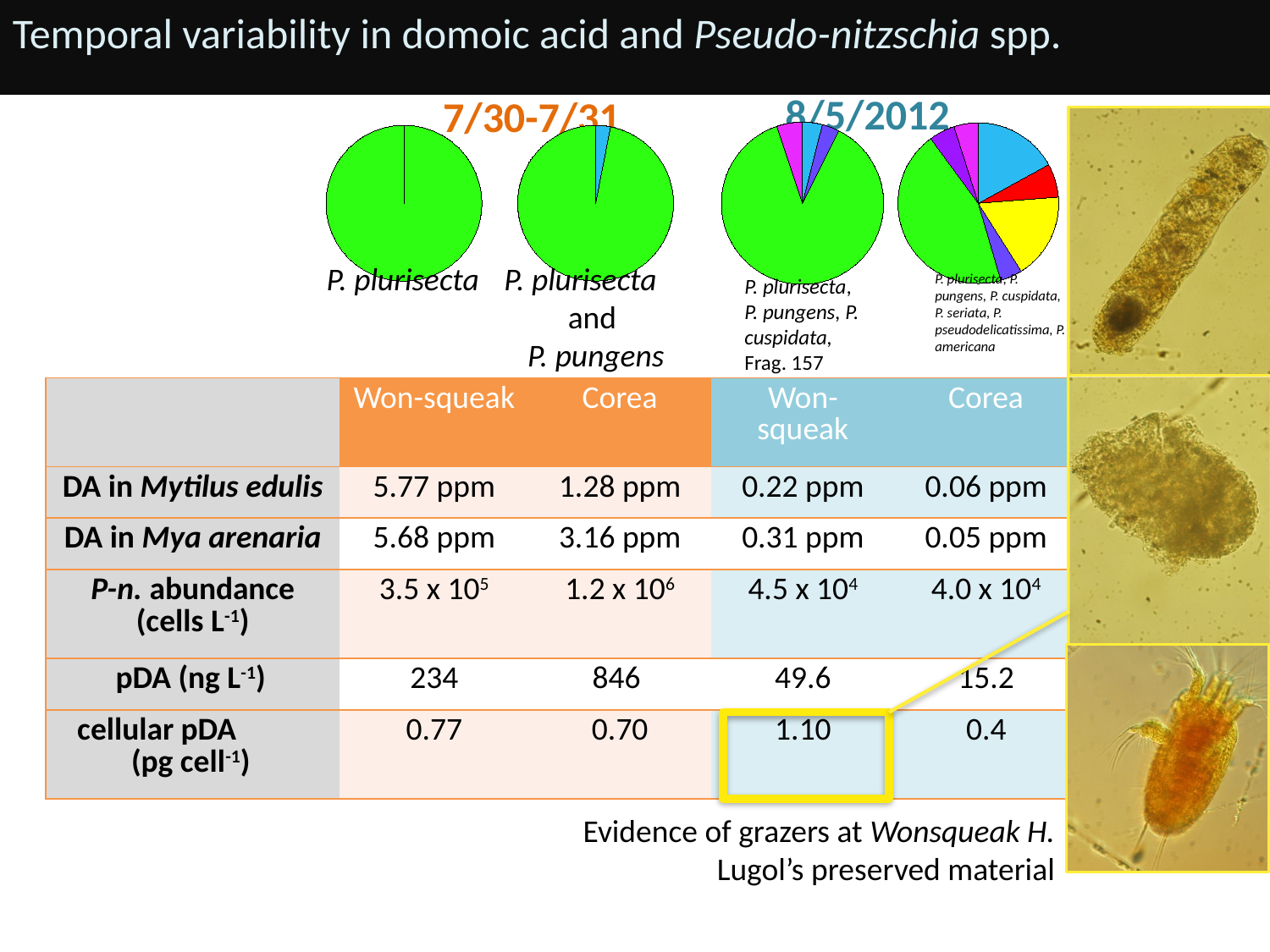
Which date label is shown above the two right-hand pie charts? 8/5/2012 In the third pie chart from the left (8/5/2012, Won-squeak), which colour slice is the largest? Green In the rightmost pie chart (8/5/2012, Corea), which colour slice is the largest? Green How many pie charts are shown on the slide? 4 In the second pie chart from the left (labelled P. plurisecta and P. pungens), how many slices are there? 2 In the second pie chart from the left (labelled P. plurisecta and P. pungens), which colour slice is the smallest? Blue In the second pie chart from the left, is the green slice larger or smaller than the blue slice? Larger In the second pie chart from the left (labelled P. plurisecta and P. pungens), which colour slice is the largest? Green Which date label is shown above the two left-hand pie charts? 7/30-7/31 What kind of charts are shown at the top of the slide? Pie charts